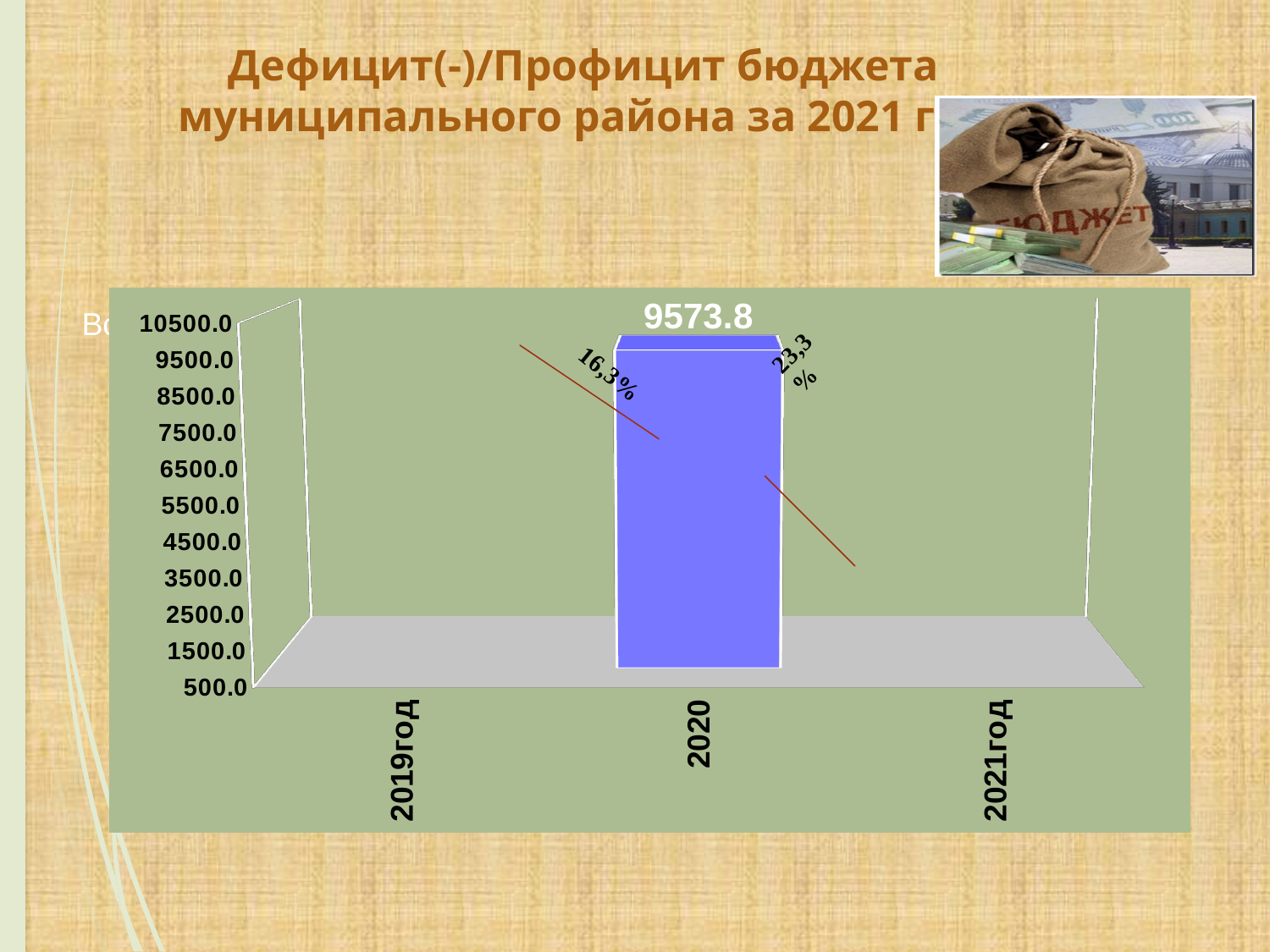
How many year categories are shown on the x axis? 3 Which year has the tallest bar in the chart? 2020 What value is labelled on the bar for 2020? 9573.8 Which year categories are labelled on the x axis? 2019год, 2020, 2021год What is the highest tick value shown on the vertical axis? 10500.0 Is the value for 2020 greater or less than 8500? greater What kind of chart is shown on the slide? bar chart Is the value for 2020 greater or less than 10500? less What is the lowest tick value shown on the vertical axis? 500.0